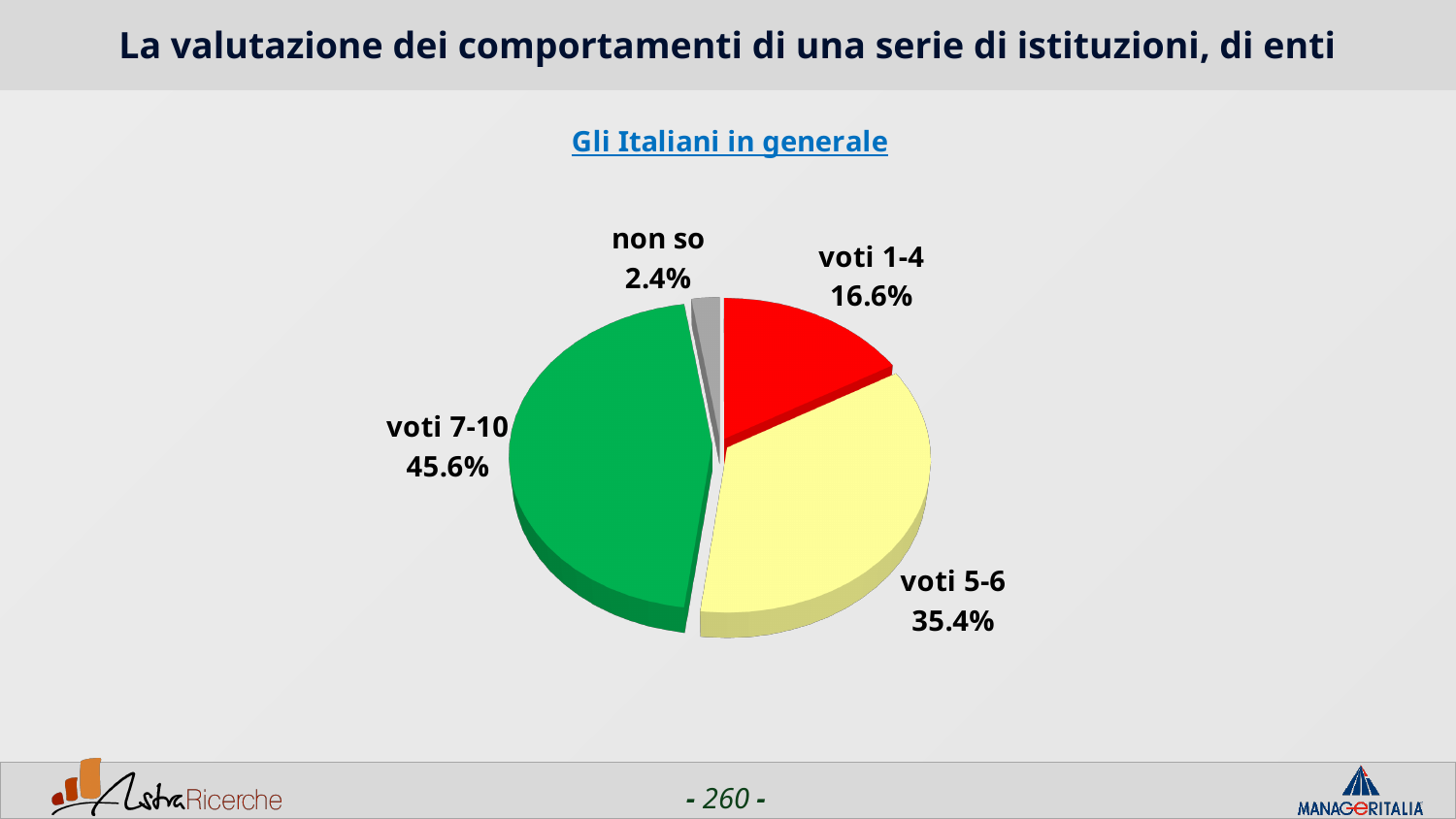
What is the difference between the values for 'voti 1-4' and 'non so'? 14.2% What is the value for 'voti 1-4'? 16.6% What kind of chart is shown on the slide? Pie chart Which category has the largest slice of the pie? voti 7-10 What is the subtitle shown above the chart? Gli Italiani in generale Which is larger, the value for 'voti 5-6' or the value for 'voti 1-4'? voti 5-6 What is the value for 'non so'? 2.4% What is the difference between the values for 'voti 7-10' and 'voti 5-6'? 10.2% What share of the pie does 'voti 7-10' represent? 45.6% Which category has the smallest slice of the pie? non so What is the value for 'voti 5-6'? 35.4% How many categories are shown in the pie chart? 4